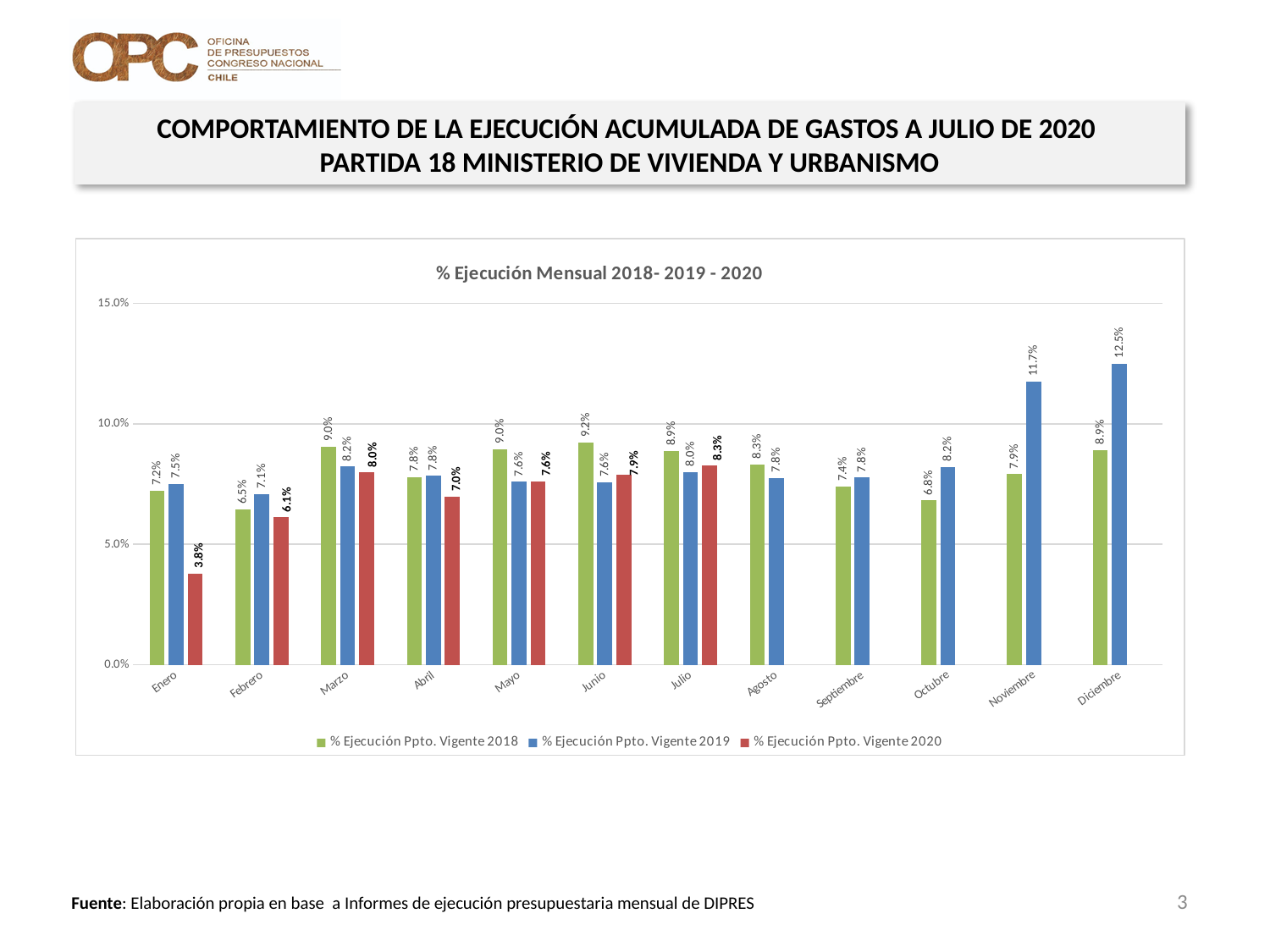
What is the difference between the 2019 and 2020 values in Enero? 3.7% What is the title of the chart? % Ejecución Mensual 2018- 2019 - 2020 How many series does the legend list? 3 Which is larger in Julio: the 2018 value or the 2020 value? 2018 value (8.9%) How many months have a bar for % Ejecución Ppto. Vigente 2020? 7 Which month has the highest value for % Ejecución Ppto. Vigente 2019? Diciembre What kind of chart is shown on the slide? Bar chart What is the value for % Ejecución Ppto. Vigente 2018 in Junio? 9.2% What is the value for % Ejecución Ppto. Vigente 2019 in Diciembre? 12.5% Is the value for % Ejecución Ppto. Vigente 2019 in Noviembre greater or less than 10.0%? greater What is the value for % Ejecución Ppto. Vigente 2020 in Enero? 3.8% Which month has the lowest value for % Ejecución Ppto. Vigente 2020? Enero